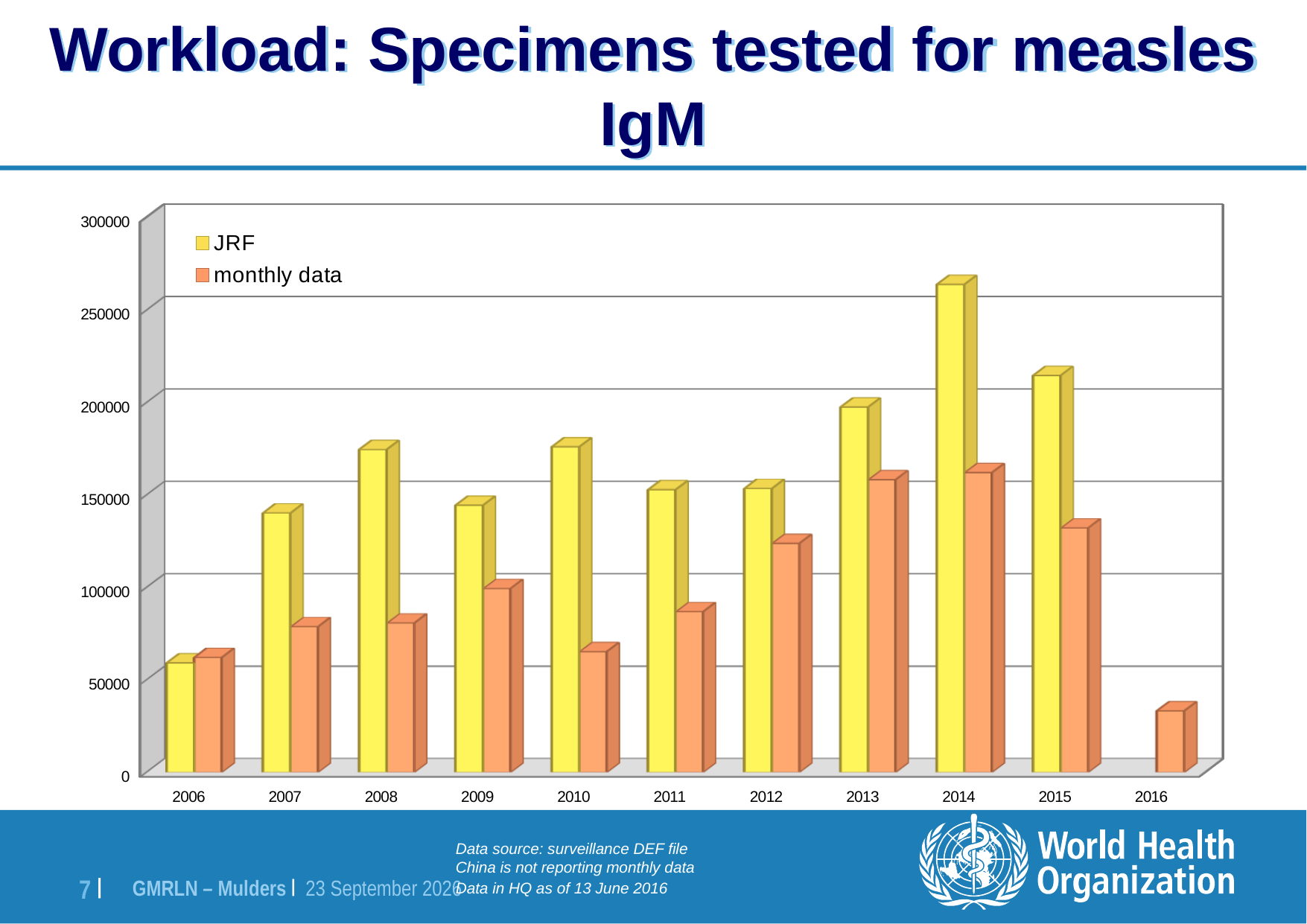
Which year has the highest JRF value? 2014 How many years are shown on the x axis? 11 Which year has the lowest monthly data value? 2016 Which year has the lowest JRF value? 2006 Is the JRF value for 2014 greater or less than 250000? greater How many series does the legend list? 2 Which series is shown in yellow? JRF Is the JRF value for 2008 greater or less than 150000? greater Is the monthly data value for 2016 greater or less than 50000? less What kind of chart is shown on the slide? bar chart In 2010, which series has the larger value, JRF or monthly data? JRF